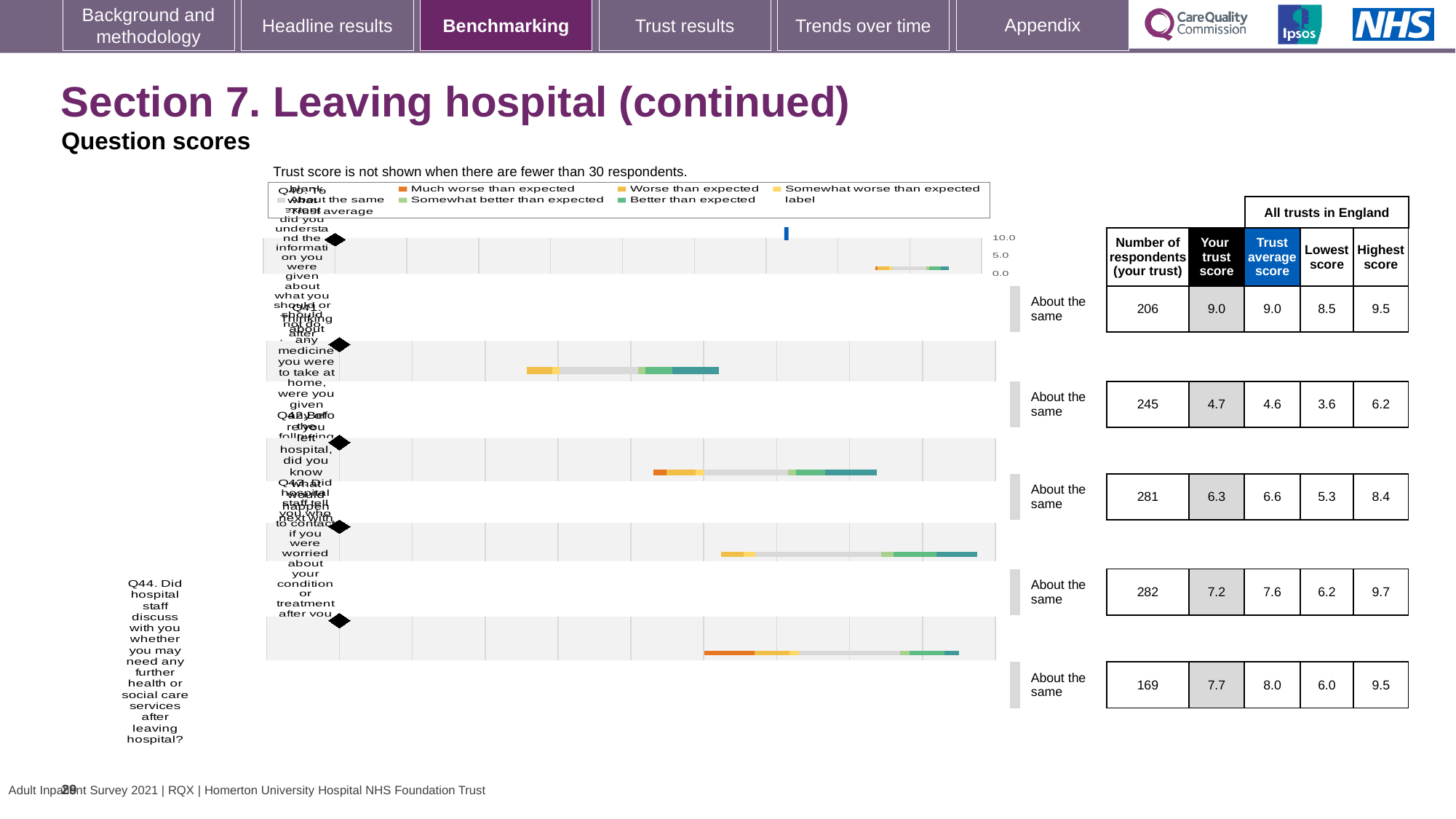
For Q44, which is larger: your trust score or the trust average score? Trust average score Which question row has the lowest 'Your trust score'? The second row (4.7) In the table, what is the 'Your trust score' for Q44 (discussing whether you may need further health or social care services after leaving hospital)? 7.7 How many respondents (your trust) are listed for Q44? 169 Which question row has the highest 'Your trust score'? The first row (9.0) What is the highest score across all trusts in England for Q44? 9.5 What is the lowest score across all trusts in England for Q44? 6.0 How many respondents (your trust) are listed for the first question row on the slide? 206 What is the trust average score for Q44? 8.0 For Q44, what is the difference between the trust average score and your trust score? 0.3 What benchmark category label is shown next to the Q44 row? About the same How many question rows are shown in the benchmarking chart and table? 5